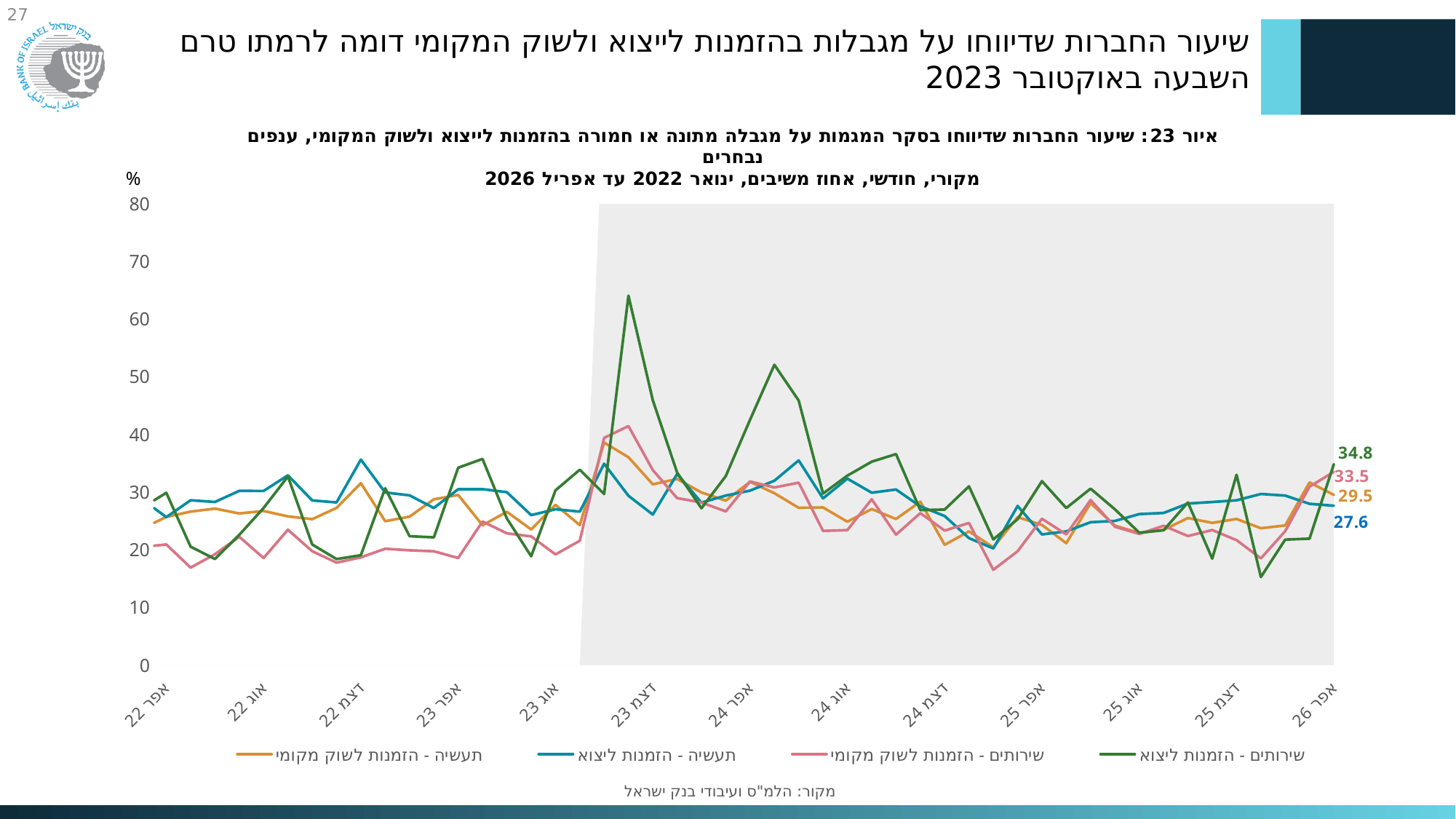
What kind of chart is shown on the slide? line chart At the end of the chart, which is larger: the value for שירותים - הזמנות לשוק מקומי or the value for תעשיה - הזמנות לשוק מקומי? שירותים - הזמנות לשוק מקומי What is the final value (April 2026) shown for the series תעשיה - הזמנות לשוק מקומי? 29.5 How many series does the legend list? 4 What is the source cited below the chart? הלמ"ס ועיבודי בנק ישראל What is the difference between the final values of שירותים - הזמנות ליצוא (34.8) and תעשיה - הזמנות ליצוא (27.6)? 7.2 What is the final value (April 2026) shown for the series שירותים - הזמנות ליצוא? 34.8 Which series has the highest value at the end of the chart (April 2026)? שירותים - הזמנות ליצוא What is the final value (April 2026) shown for the series תעשיה - הזמנות ליצוא? 27.6 Which series has the lowest value at the end of the chart (April 2026)? תעשיה - הזמנות ליצוא Is the peak value of the series שירותים - הזמנות ליצוא around December 2023 greater or less than 60? greater What is the final value (April 2026) shown for the series שירותים - הזמנות לשוק מקומי? 33.5